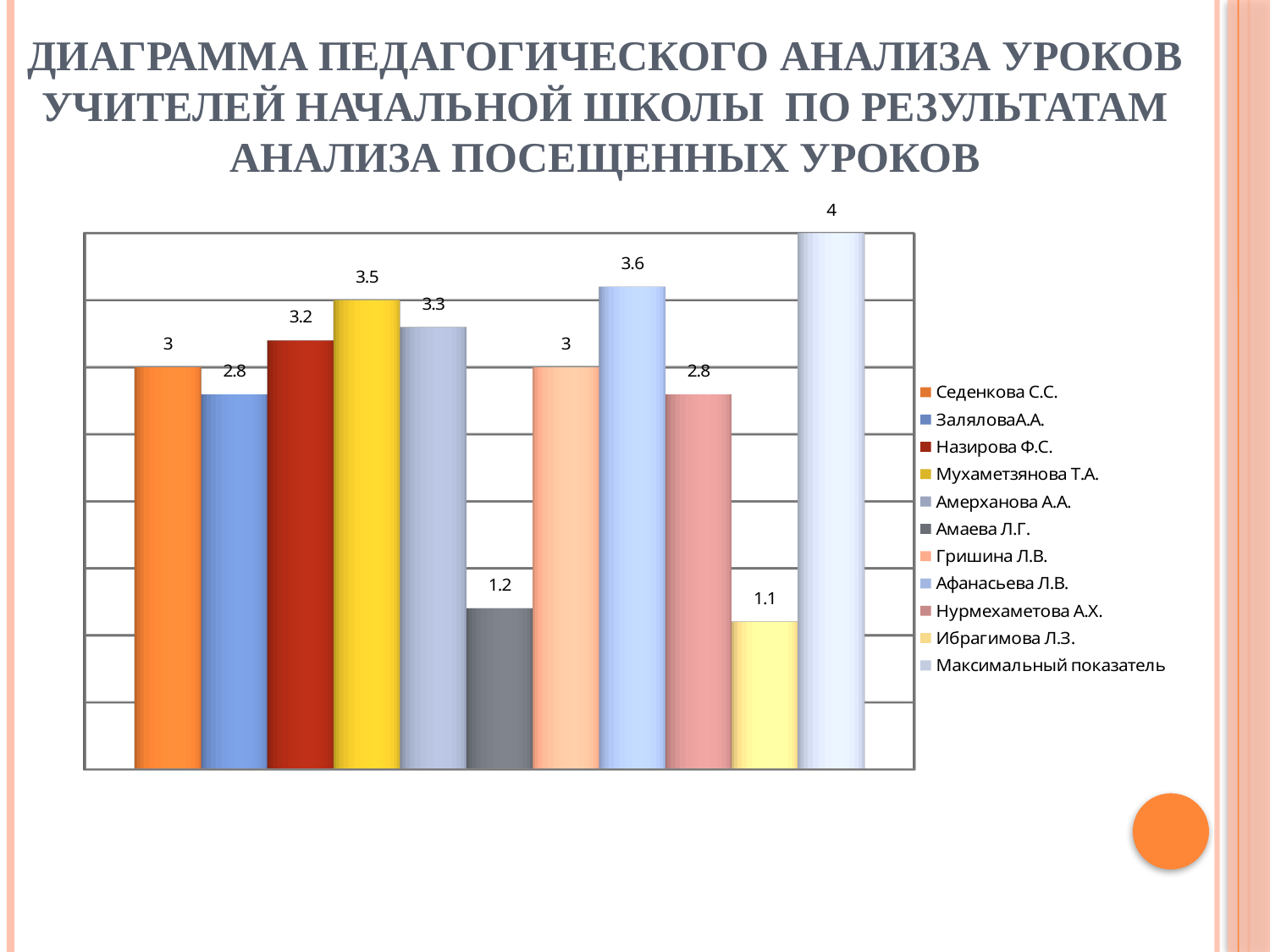
What value is shown for Амаева Л.Г.? 1.2 How many entries does the legend list? 11 Which legend entry has the lowest value? Ибрагимова Л.З. What value is shown for Мухаметзянова Т.А.? 3.5 Which is larger, the value for Амерханова А.А. or the value for Нурмехаметова А.Х.? Амерханова А.А. What kind of chart is shown on the slide? Bar chart What is the difference between the values for Назирова Ф.С. and Залялова А.А.? 0.4 What is the difference between the value for Максимальный показатель and the value for Афанасьева Л.В.? 0.4 Among the teachers (excluding Максимальный показатель), who has the highest value? Афанасьева Л.В. What value is shown for Афанасьева Л.В.? 3.6 Which legend entry has the highest value? Максимальный показатель What value is shown for Максимальный показатель? 4